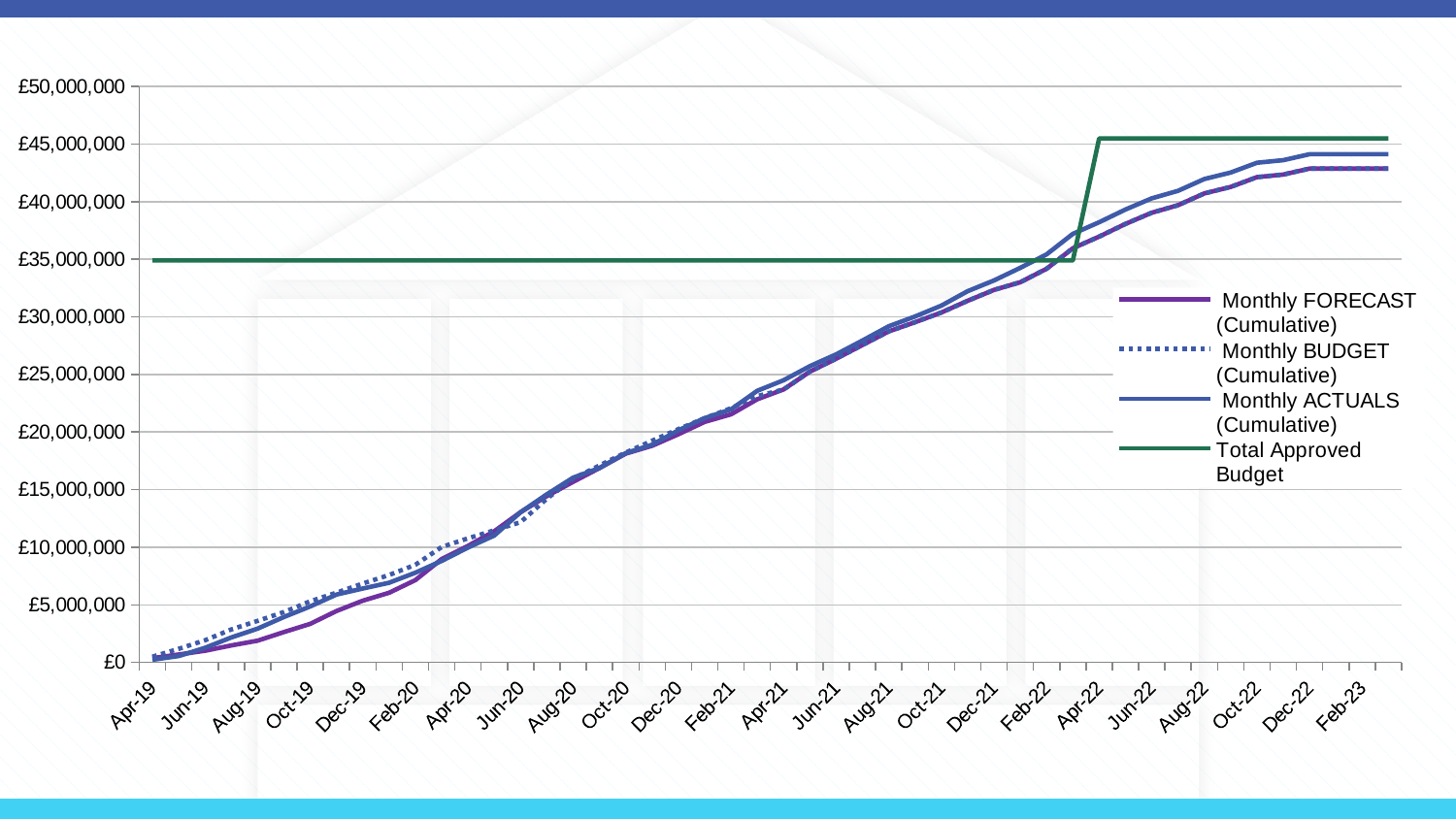
Is the Total Approved Budget at Feb-23 greater or less than £40,000,000? greater What kind of chart is shown on the slide? Line chart Is the Monthly FORECAST (Cumulative) value at Feb-23 greater or less than £45,000,000? less What colour is the Total Approved Budget line? Green Is the Total Approved Budget at Apr-19 greater or less than £30,000,000? greater At Feb-23, which is higher: Monthly ACTUALS (Cumulative) or Monthly FORECAST (Cumulative)? Monthly ACTUALS (Cumulative) Which series is plotted as a dotted line? Monthly BUDGET (Cumulative) Does the Monthly ACTUALS (Cumulative) line rise or fall from Apr-19 to Feb-23? Rise How many series does the legend list? 4 Which series has the highest value at Feb-23? Total Approved Budget